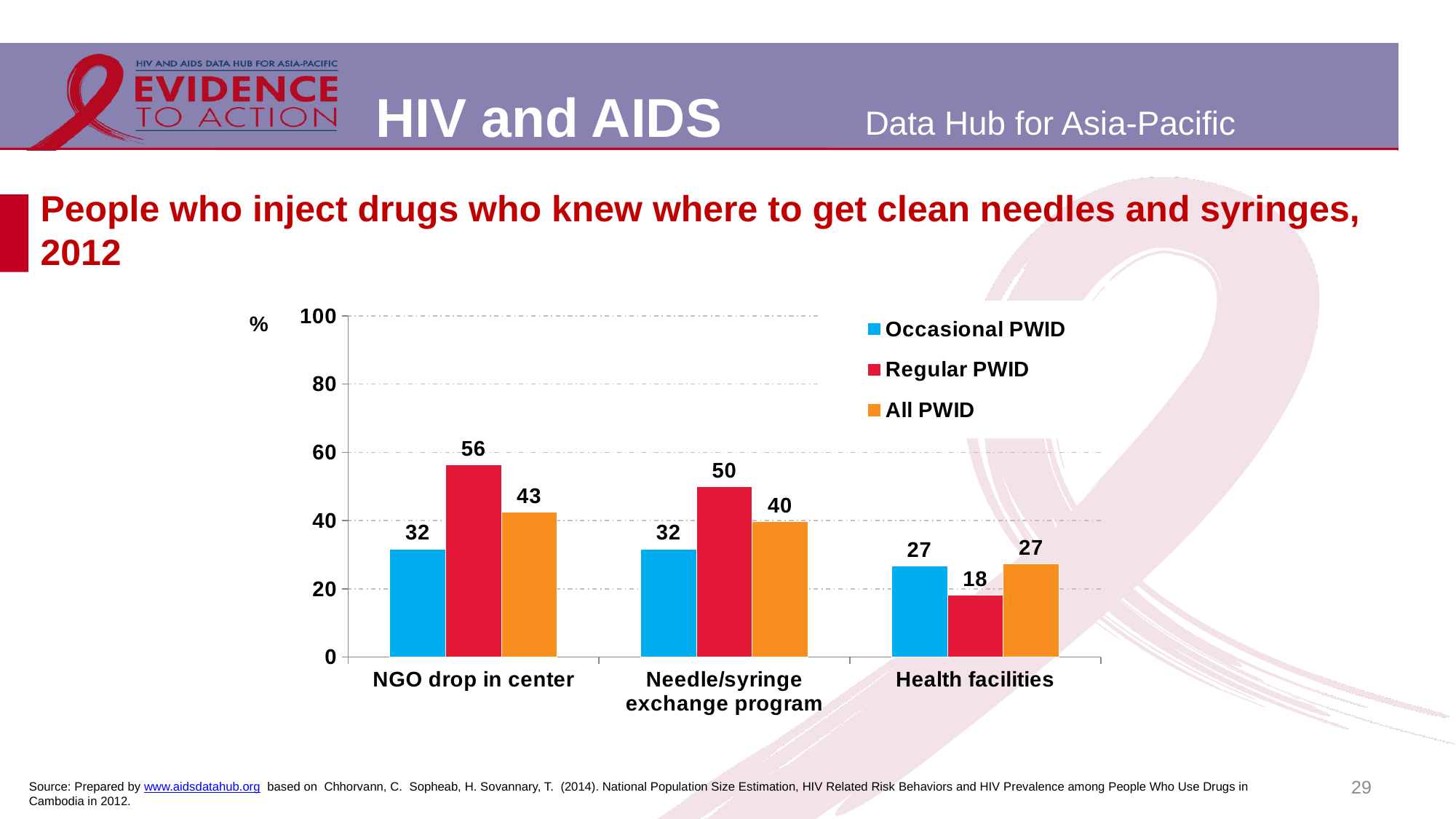
How many series does the legend list? 3 Which colour represents All PWID in the legend? Orange Which category has the highest value for Regular PWID? NGO drop in center What is the difference between Regular PWID and Occasional PWID at NGO drop in center? 24 Is the value for Regular PWID at Needle/syringe exchange program greater or less than 40? greater What is the value for Regular PWID at NGO drop in center? 56 Which is larger at Health facilities: Occasional PWID or Regular PWID? Occasional PWID How many categories are shown on the x axis? 3 Which category has the lowest value for All PWID? Health facilities What is the value for Regular PWID at Health facilities? 18 What kind of chart is shown on the slide? Bar chart What is the value for All PWID at Needle/syringe exchange program? 40